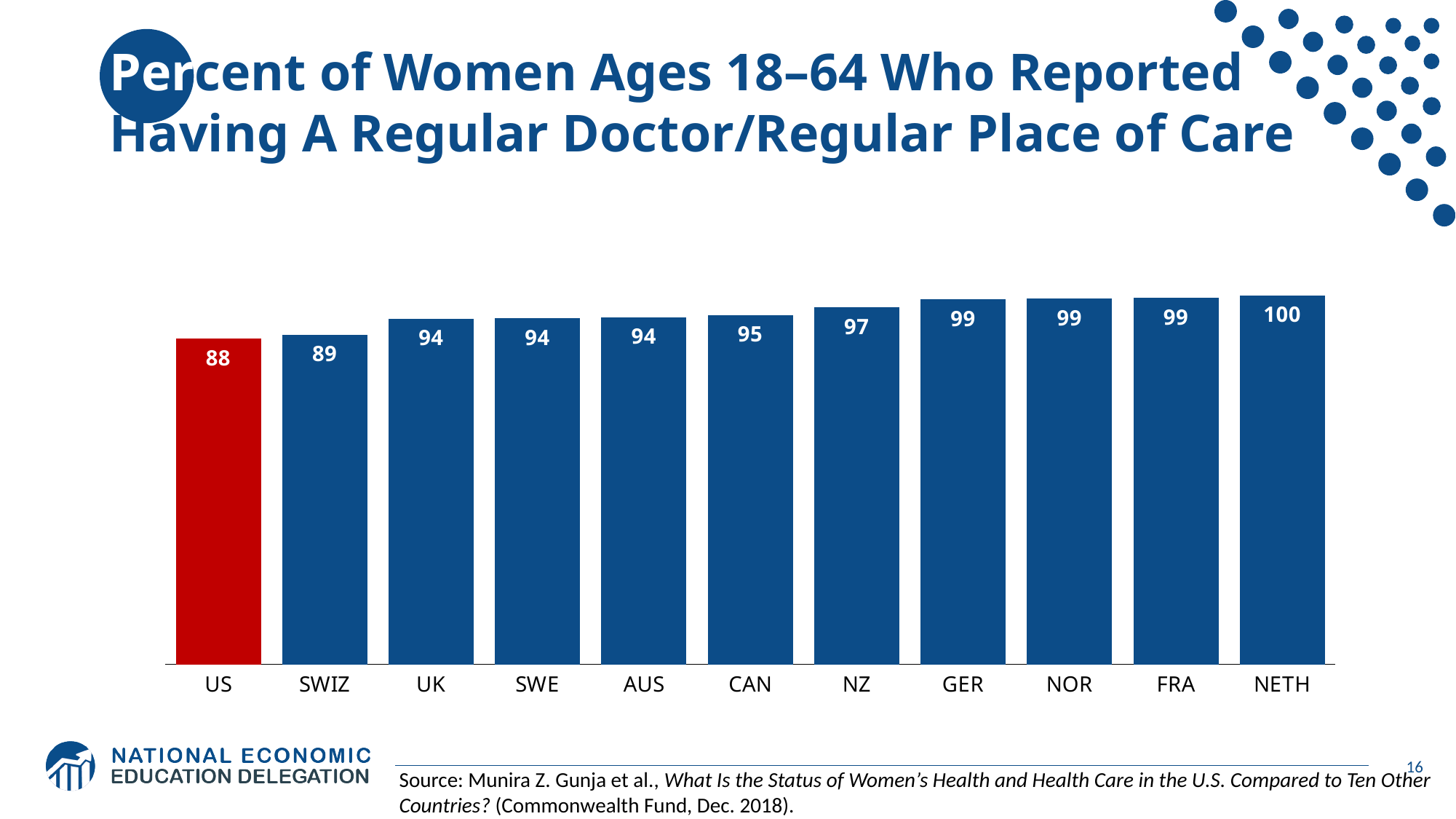
What is the value for the US? 88 How many countries are shown in the chart? 11 What is the value for CAN? 95 Which country has the lowest value? US What is the difference between the values for SWIZ and the US? 1 What kind of chart is shown on the slide? bar chart What is the value for NZ? 97 What is the difference between the values for NETH and the US? 12 Which country has the highest value? NETH Which has a larger value, UK or NZ? NZ Which bar is coloured red rather than blue? US Do the values rise or fall moving from left to right across the chart? rise